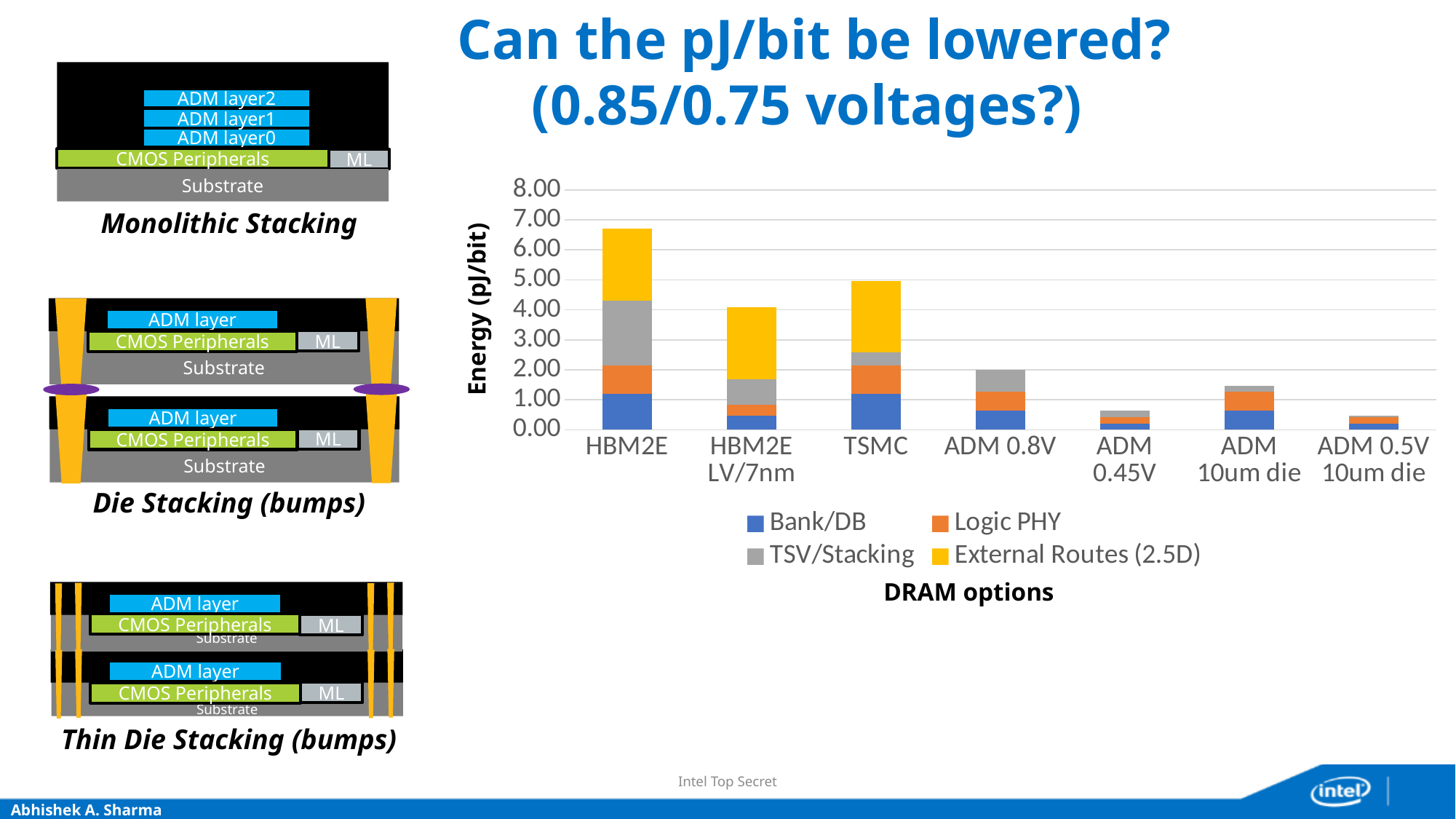
Is the total energy for HBM2E LV/7nm greater or less than 3.00 pJ/bit? greater Is the total energy for HBM2E greater or less than 6.00 pJ/bit? greater Is the total energy for ADM 0.5V 10um die greater or less than 1.00 pJ/bit? less How many series does the chart's legend list? 4 What is the label of the chart's vertical axis? Energy (pJ/bit) How many DRAM options (categories) are plotted on the x axis of the chart? 7 Which has a larger total energy, HBM2E or HBM2E LV/7nm? HBM2E Which DRAM option has the highest total energy in the chart? HBM2E What kind of chart is shown on the slide? stacked bar chart Which legend entry is shown in yellow in the chart? External Routes (2.5D)